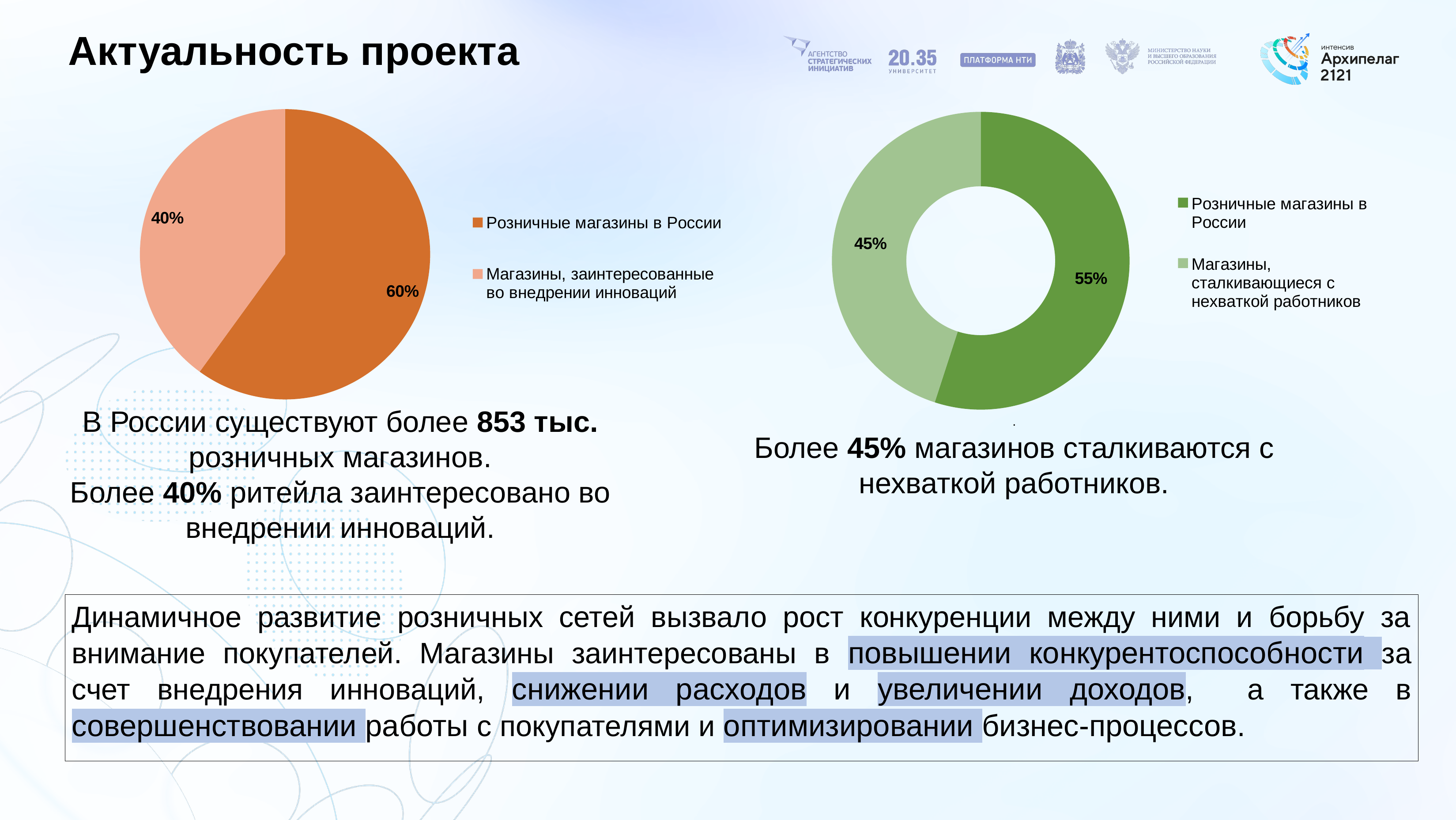
How many slices does the left pie chart have? 2 In the left pie chart, what share is labelled for "Розничные магазины в России"? 60% In the right doughnut chart, which is larger: the slice for "Розничные магазины в России" or the slice for "Магазины, сталкивающиеся с нехваткой работников"? Розничные магазины в России What colour is the slice for "Магазины, заинтересованные во внедрении инноваций" in the left pie chart? Light orange In the right doughnut chart, what is the difference between the two slices' percentages? 10% In the right doughnut chart, which category has the smallest slice? Магазины, сталкивающиеся с нехваткой работников In the left pie chart, what share is labelled for "Магазины, заинтересованные во внедрении инноваций"? 40% In the left pie chart, which category has the largest slice? Розничные магазины в России In the left pie chart, what is the difference between the two slices' percentages? 20% What type of chart is the chart on the right side of the slide? Doughnut chart In the right doughnut chart, what share is labelled for "Магазины, сталкивающиеся с нехваткой работников"? 45% In the right doughnut chart, what share is labelled for "Розничные магазины в России"? 55%